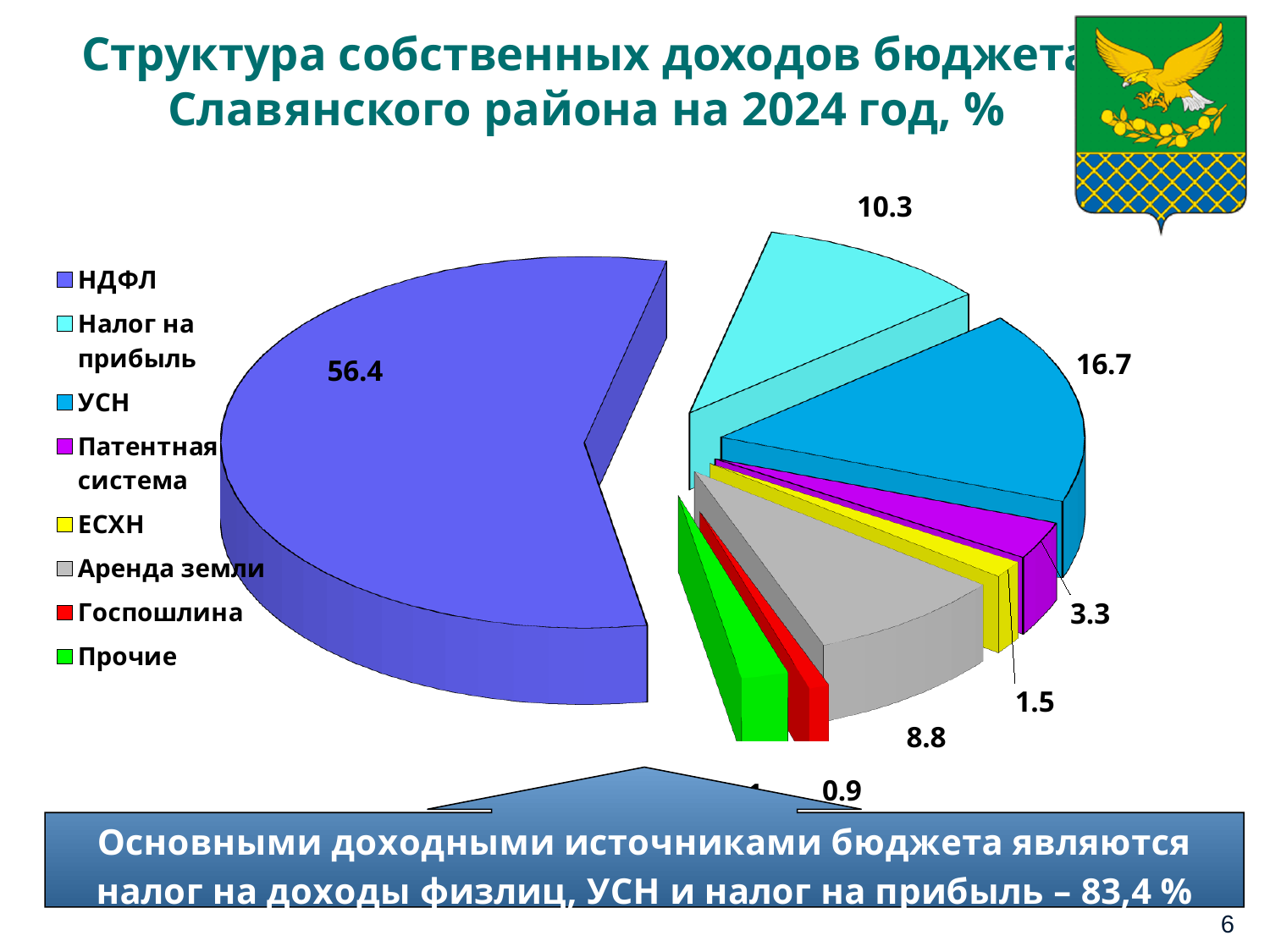
What is the value for ЕСХН in the pie chart? 1.5 What is the value for НДФЛ in the pie chart? 56.4 What is the value for Госпошлина in the pie chart? 0.9 What is the difference between the values for НДФЛ and УСН? 39.7 Which is larger, УСН or Налог на прибыль? УСН What is the value for УСН in the pie chart? 16.7 What is the value for Патентная система in the pie chart? 3.3 What is the value for Налог на прибыль in the pie chart? 10.3 Which category has the largest share of the pie chart? НДФЛ What kind of chart is shown on the slide? Pie chart How many categories does the legend of the pie chart list? 8 What is the value for Аренда земли in the pie chart? 8.8